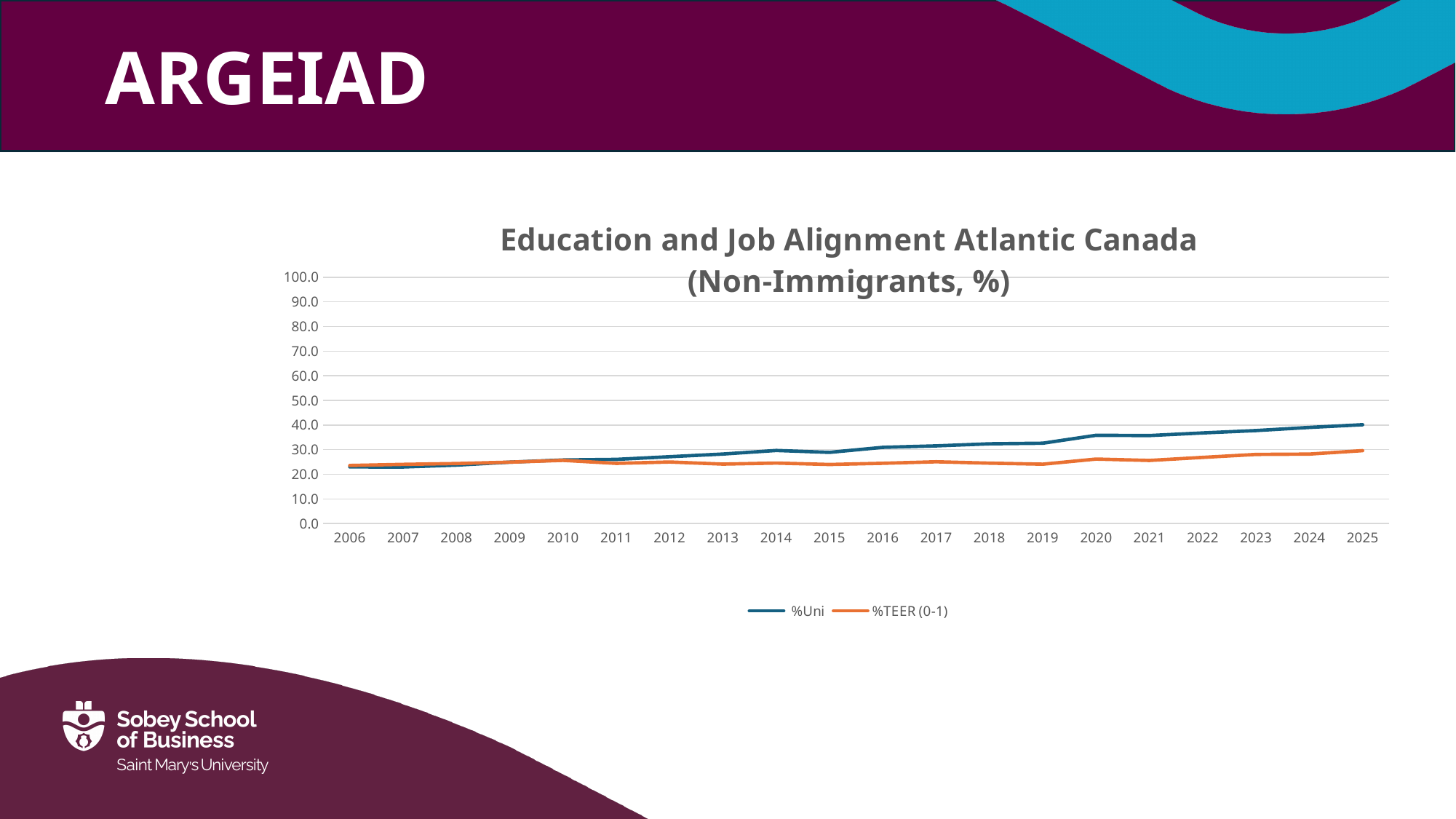
Is the value for %Uni in 2025 greater or less than 30? greater In which year is the %Uni value highest? 2025 Is the value for %TEER (0-1) in 2025 greater or less than 40? less Is the value for %Uni in 2025 greater or less than 50? less In 2025, which series has the higher value, %Uni or %TEER (0-1)? %Uni How many years are shown along the x axis? 20 What are the two series named in the legend? %Uni and %TEER (0-1) Does the %Uni series generally rise or fall from 2006 to 2025? rise What is the title of the chart? Education and Job Alignment Atlantic Canada (Non-Immigrants, %) What kind of chart is shown on the slide? line chart How many series does the legend list? 2